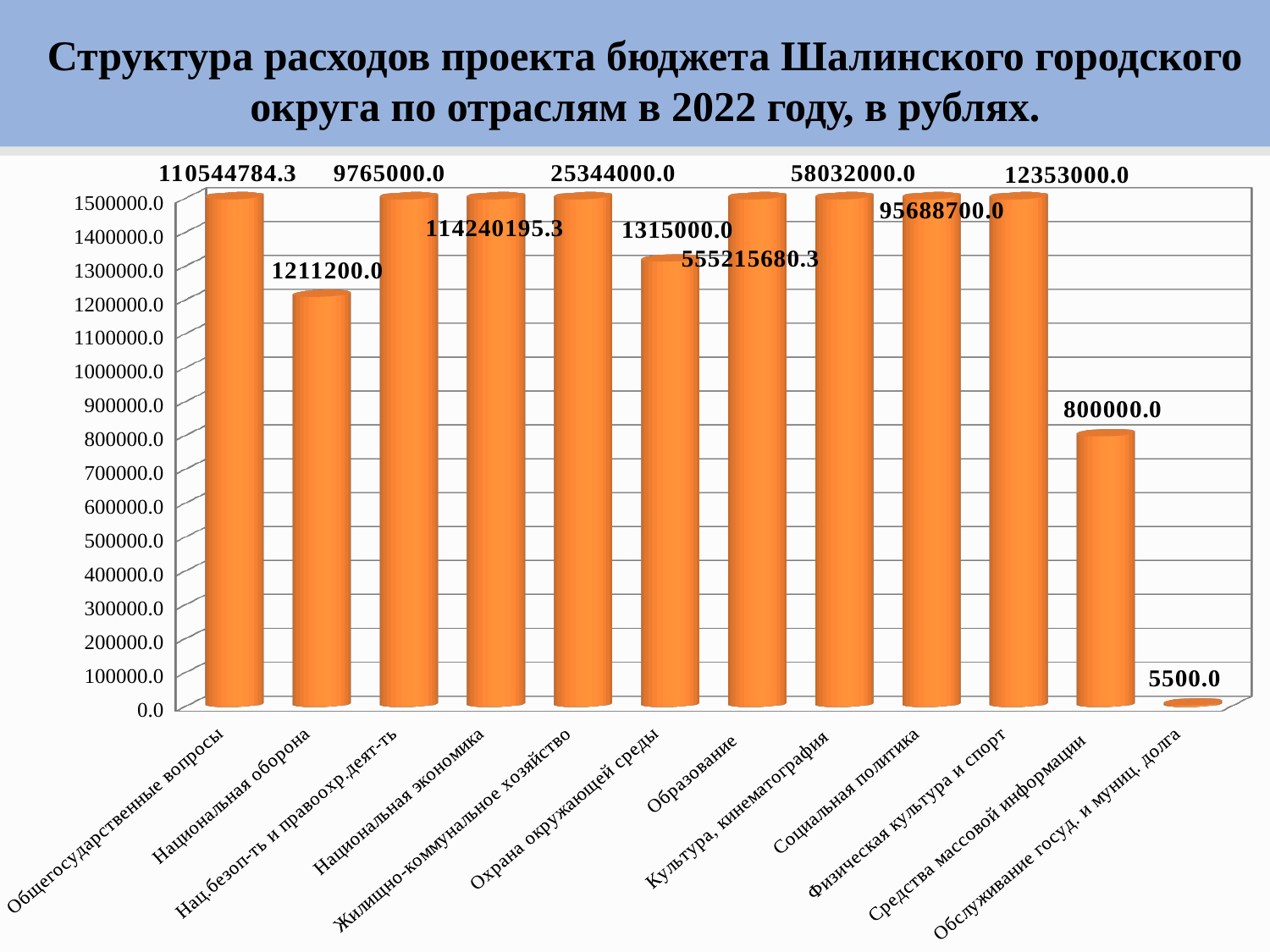
What is the value for Средства массовой информации? 800000.0 What kind of chart is this? bar chart What is the value for Обслуживание госуд. и муниц. долга? 5500.0 What is the difference between the values for Национальная оборона and Средства массовой информации? 411200.0 How many categories are shown on the x axis? 12 What is the value for Образование? 555215680.3 What is the value for Жилищно-коммунальное хозяйство? 25344000.0 Which is larger, the value for Национальная экономика or the value for Общегосударственные вопросы? Национальная экономика What is the value for Национальная оборона? 1211200.0 Which category has the highest value? Образование Which category has the lowest value? Обслуживание госуд. и муниц. долга What is the value for Социальная политика? 95688700.0